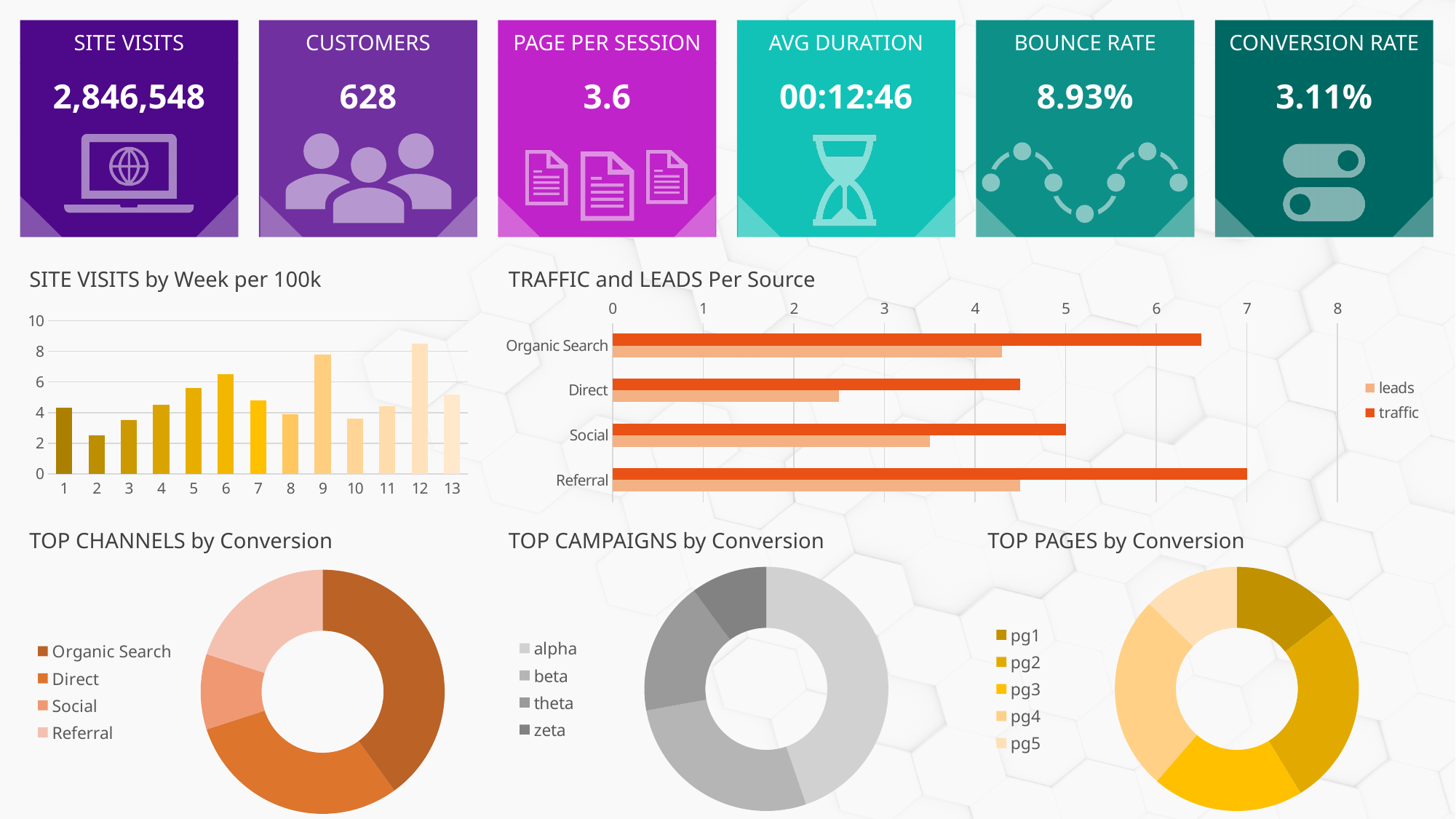
How many series does the legend of the "TRAFFIC and LEADS Per Source" chart list? 2 In the "TRAFFIC and LEADS Per Source" chart, which source has the lowest traffic value? Direct In the "TRAFFIC and LEADS Per Source" chart, is the leads value for Direct greater or less than 3? less What kind of chart is "SITE VISITS by Week per 100k"? bar chart In the "TRAFFIC and LEADS Per Source" chart, which source has the highest traffic value? Referral How many categories does the "TOP PAGES by Conversion" chart show? 5 In the "TRAFFIC and LEADS Per Source" chart, is the traffic value for Organic Search larger or smaller than the traffic value for Social? larger In the "SITE VISITS by Week per 100k" chart, how many weeks are plotted? 13 In the "SITE VISITS by Week per 100k" chart, which week has the highest value? 12 In the "SITE VISITS by Week per 100k" chart, is the value for week 9 greater or less than 6? greater In the "SITE VISITS by Week per 100k" chart, which week has the lowest value? 2 What are the legend entries of the "TOP CAMPAIGNS by Conversion" chart? alpha, beta, theta, zeta